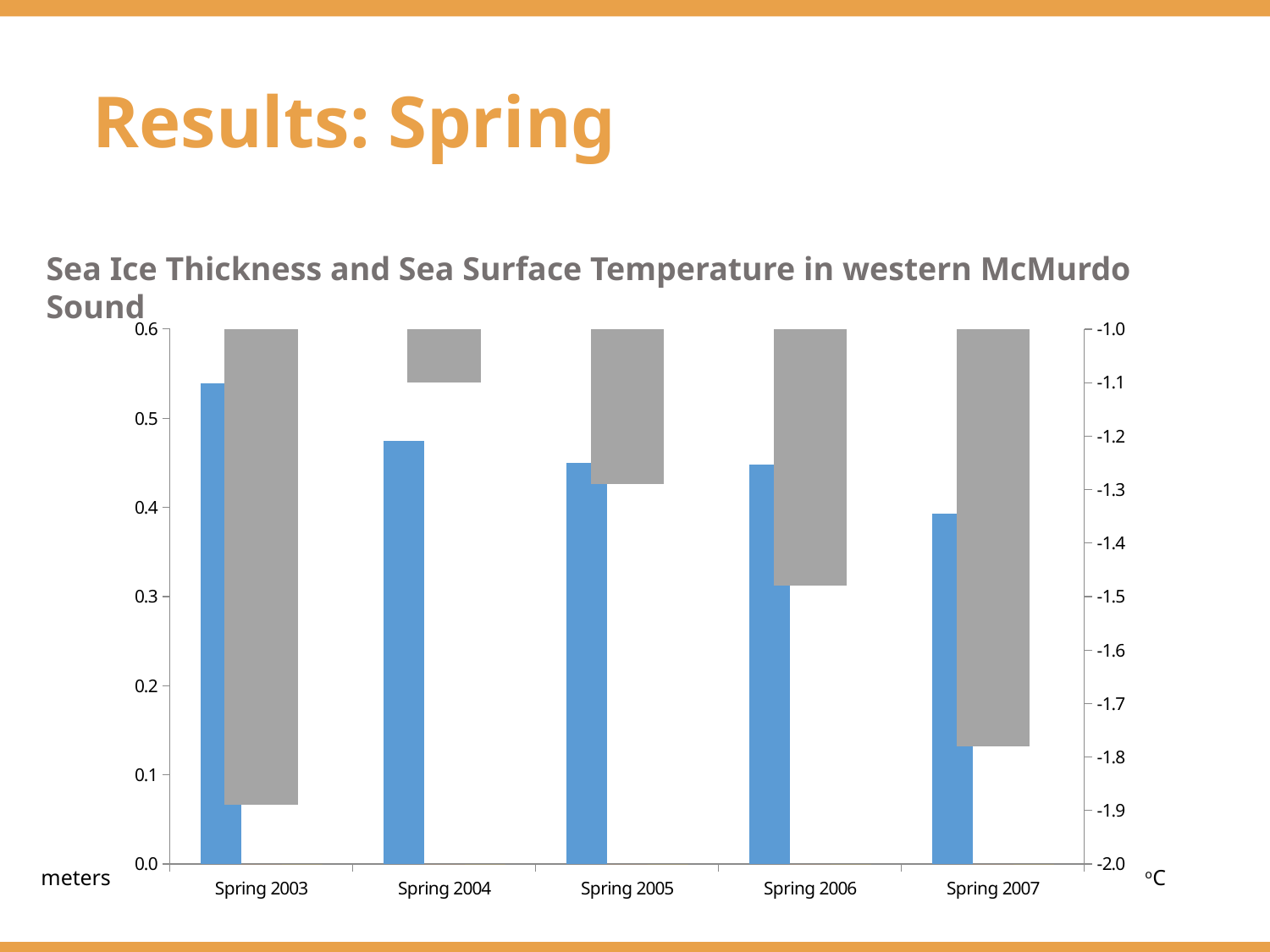
Is the blue bar (sea ice thickness) for Spring 2004 greater or less than 0.5 meters? less How many spring seasons (categories) are shown on the x axis? 5 Which spring has the tallest blue bar (sea ice thickness)? Spring 2003 Which spring has the shortest blue bar (sea ice thickness)? Spring 2007 What is the title of the chart? Sea Ice Thickness and Sea Surface Temperature in western McMurdo Sound Which blue bar is taller, Spring 2003 or Spring 2007? Spring 2003 What unit is shown on the left vertical axis? meters Do the blue bars (sea ice thickness) generally rise or fall from Spring 2003 to Spring 2007? fall Is the blue bar (sea ice thickness) for Spring 2003 greater or less than 0.5 meters? greater What kind of chart is shown on the slide? bar chart Which spring has the shortest gray bar (sea surface temperature)? Spring 2004